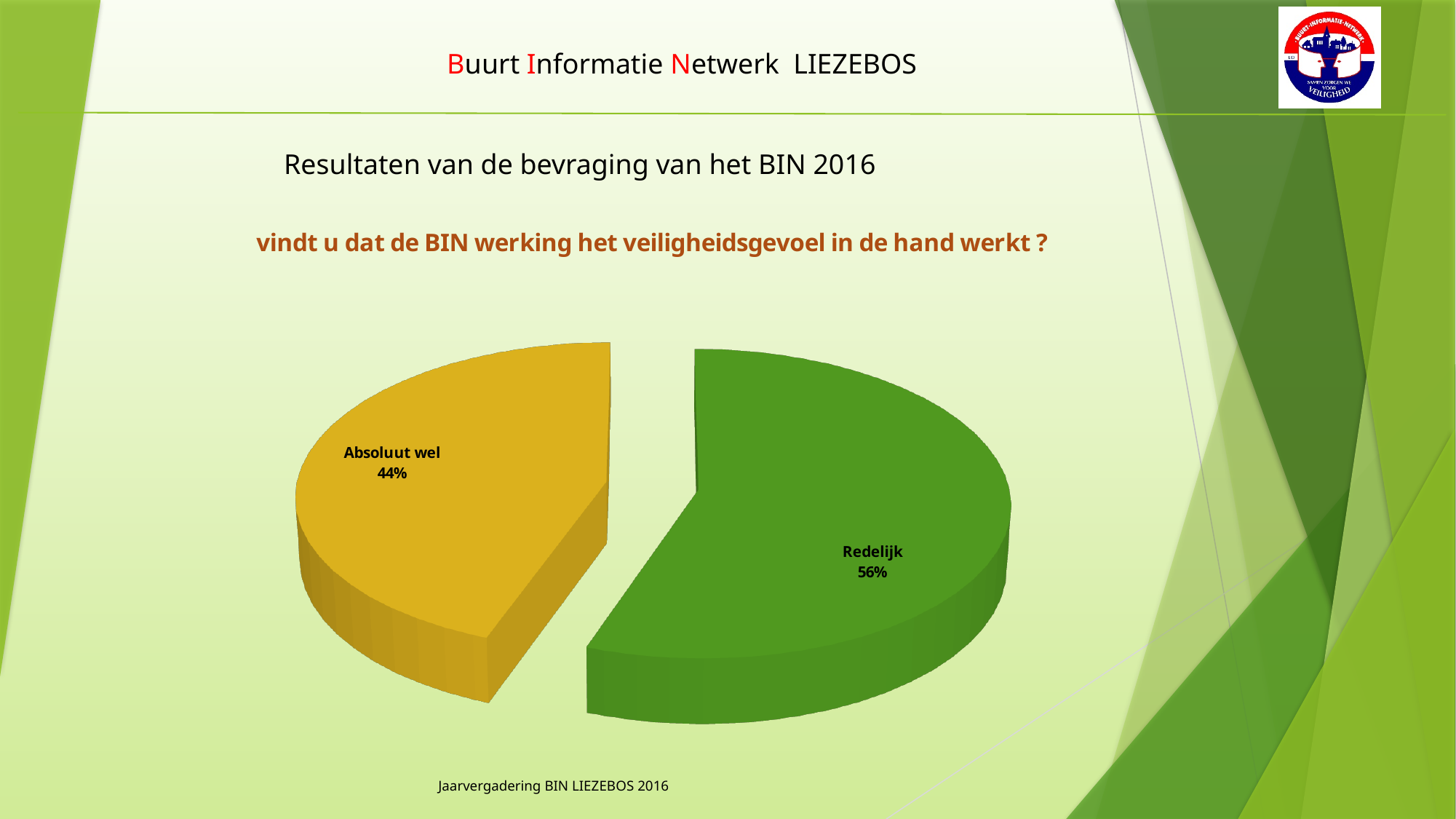
What kind of chart is shown on the slide? Pie chart Which slice of the pie is the largest? Redelijk What colour is the "Redelijk" slice? Green Which slice of the pie is the smallest? Absoluut wel Is the share for "Redelijk" greater or less than 50%? greater Which is larger, the "Absoluut wel" slice or the "Redelijk" slice? Redelijk What is the difference in percentage points between the "Redelijk" and "Absoluut wel" slices? 12 What colour is the "Absoluut wel" slice? Yellow How many slices does the pie chart have? 2 What share of the pie does the "Redelijk" slice represent? 56% Is the share for "Absoluut wel" greater or less than 50%? less What share of the pie does the "Absoluut wel" slice represent? 44%